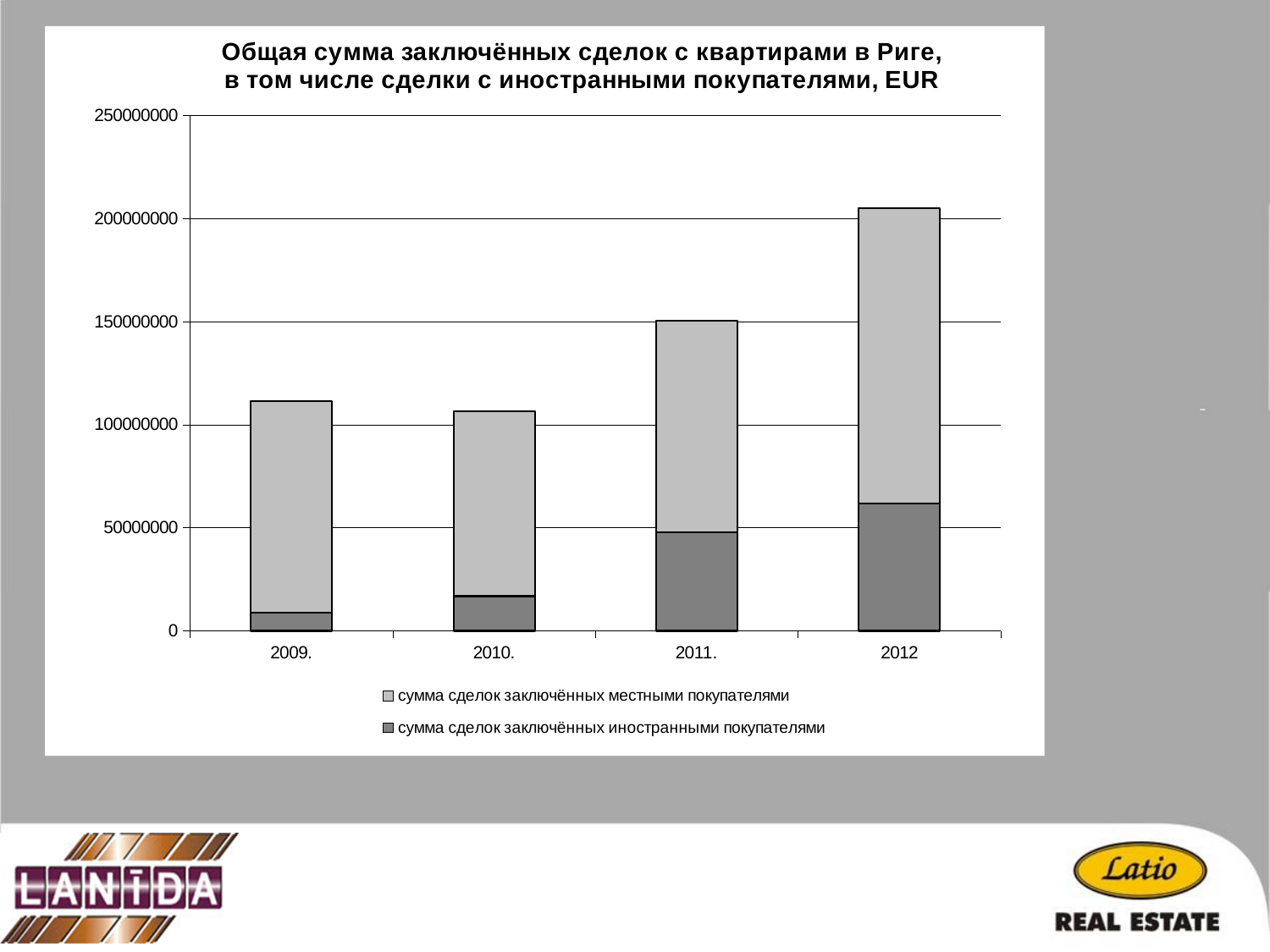
Does the sum of deals concluded by foreign buyers rise or fall from 2009. to 2012? rises Is the total value of the bar for 2009. greater or less than 100000000? greater Which legend entry is shown in the darker grey colour? сумма сделок заключённых иностранными покупателями Which year has the smallest sum of deals concluded by foreign buyers? 2009. Which year has the highest total sum of apartment deals? 2012 Is the total value of the bar for 2012 greater or less than 200000000? greater What kind of chart is shown on the slide? Stacked bar chart Which year has the lowest total sum of apartment deals? 2010. Which year has the largest sum of deals concluded by foreign buyers (сумма сделок заключённых иностранными покупателями)? 2012 How many years are shown on the x axis of the chart? 4 Is the value for foreign buyers (сумма сделок заключённых иностранными покупателями) in 2012 greater or less than 50000000? greater How many series does the chart legend list? 2